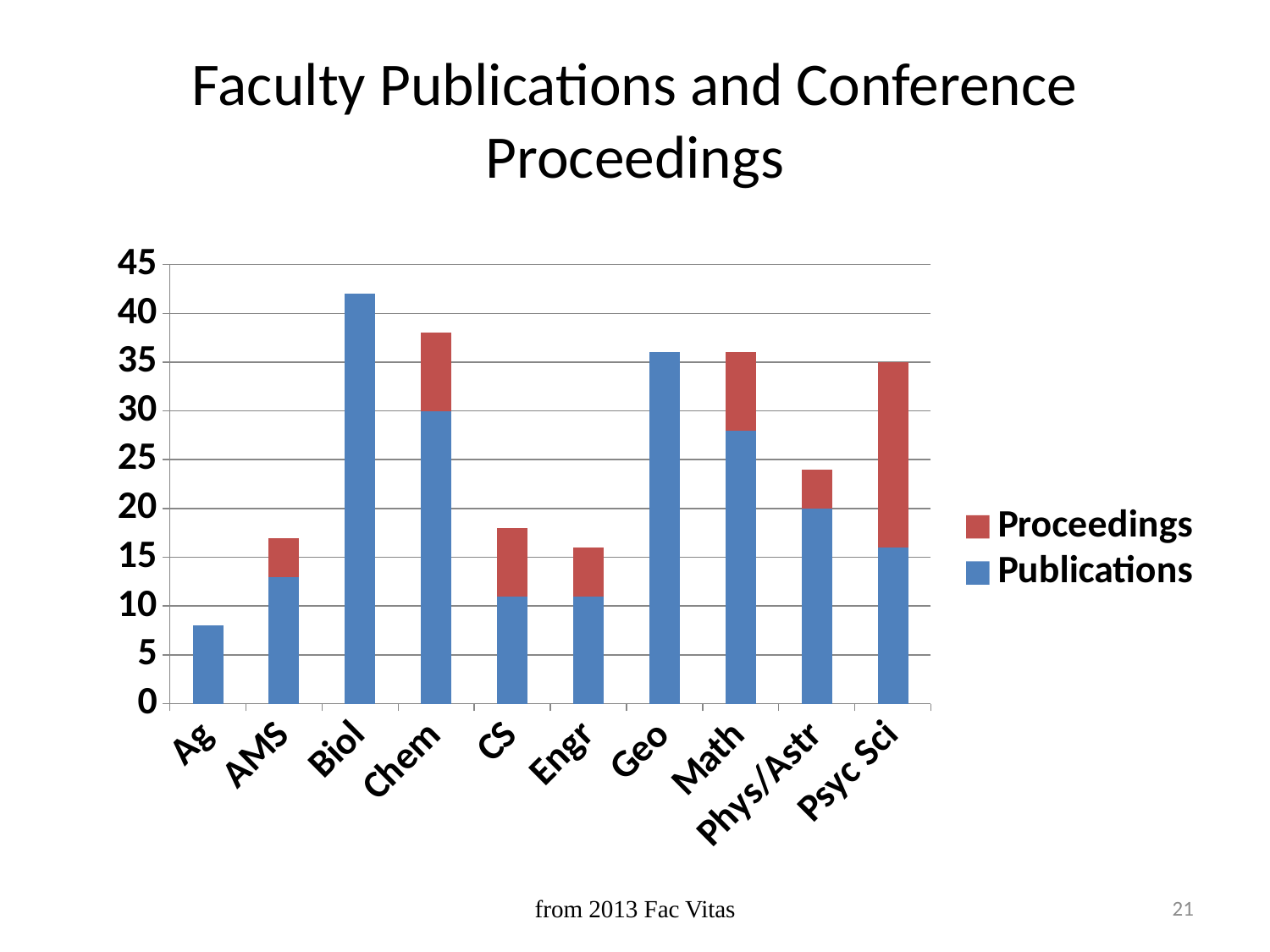
What colour represents Proceedings in the chart? Red Is the total bar for CS greater or less than 20? less How many series does the legend list? 2 What kind of chart is shown on the slide? Stacked bar chart Which category has the tallest bar overall? Biol Which category has the largest Proceedings segment? Psyc Sci Is the total bar for Biol greater or less than 40? greater How many categories are shown on the x axis of the chart? 10 Which bar is taller overall, Biol or Chem? Biol What are the two series named in the legend? Proceedings and Publications Which category has the shortest bar overall? Ag Is the total bar for Ag greater or less than 10? less